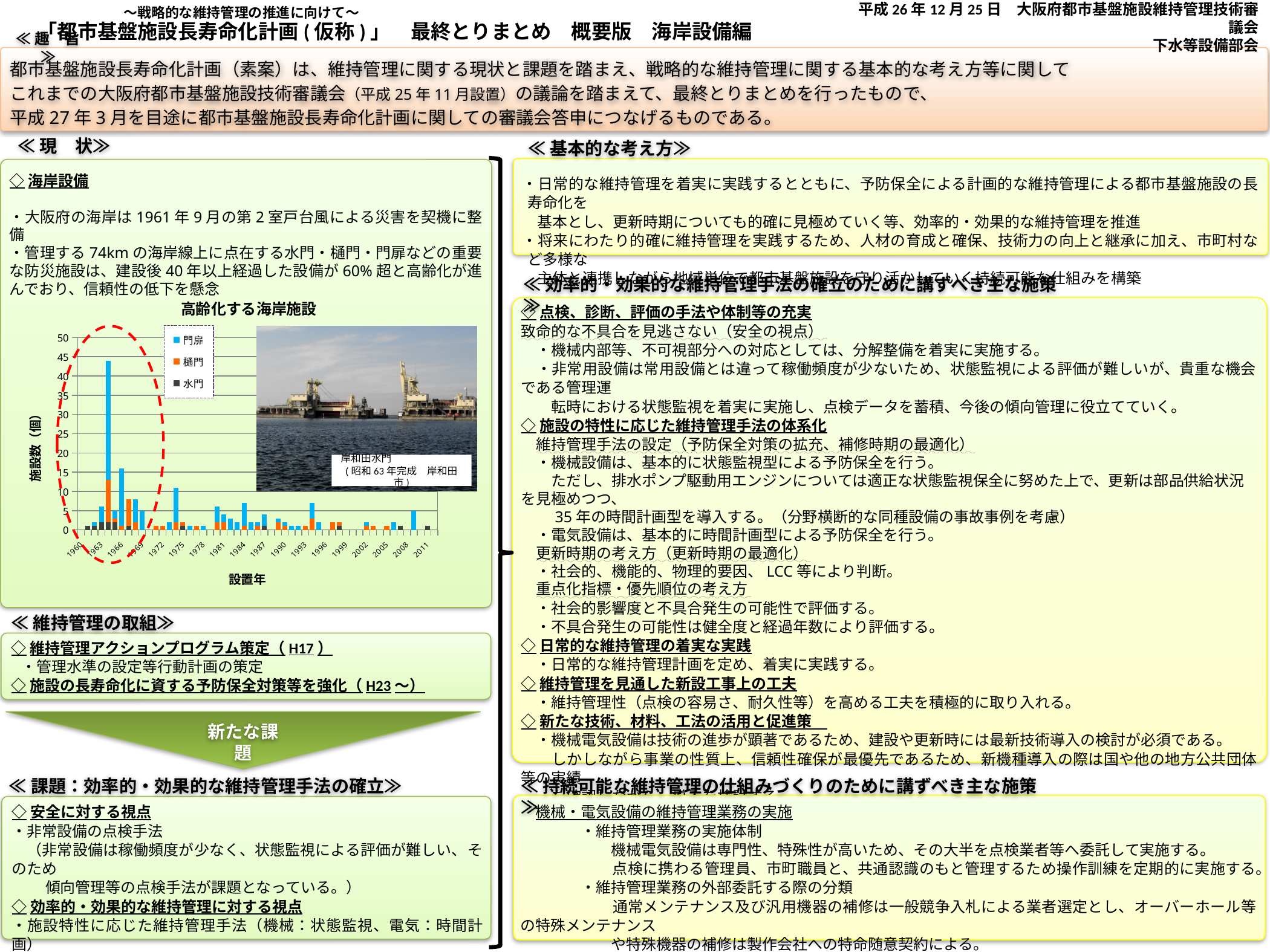
In the 高齢化する海岸施設 chart, is the value for 1960 greater or less than 5? less In the 高齢化する海岸施設 chart, is the tallest bar greater or less than 40? greater In the 高齢化する海岸施設 chart, are the bars generally taller in the mid-1960s or in the 2000s? mid-1960s In the 高齢化する海岸施設 chart, is the value for 2008 greater or less than 10? less What is the x-axis title of the 高齢化する海岸施設 chart? 設置年 How many series does the legend of the 高齢化する海岸施設 chart list? 3 In the 高齢化する海岸施設 chart, do the bar heights generally rise or fall from the mid-1960s toward 2011? fall What kind of chart is shown under the heading 高齢化する海岸施設? bar chart What is the highest tick value shown on the y-axis of the 高齢化する海岸施設 chart? 50 What are the three legend entries in the 高齢化する海岸施設 chart? 門扉, 樋門, 水門